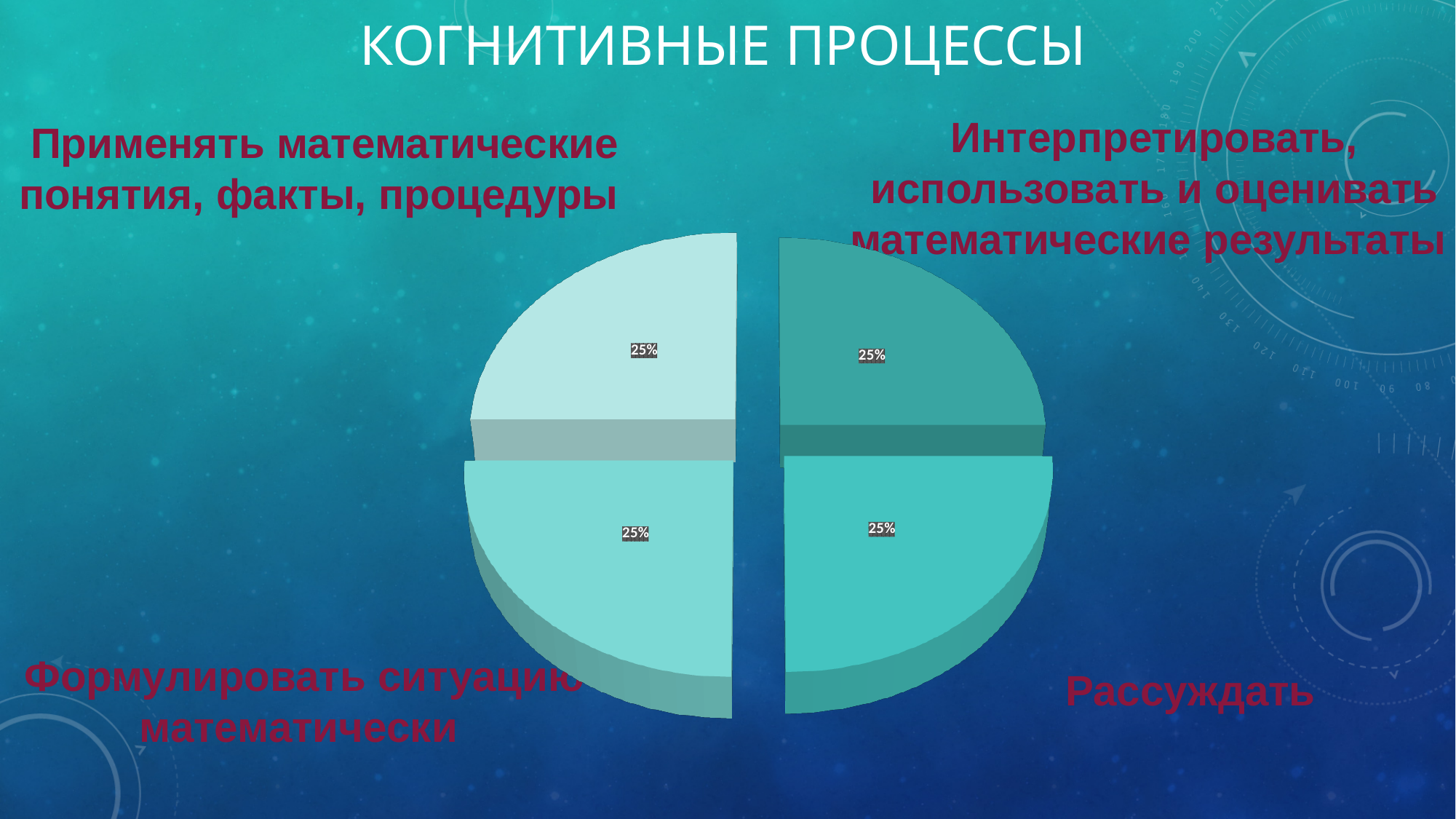
How many slices does the pie chart have? 4 What is the total of all four slice values in the pie chart? 100% What is the difference between the value of the slice labelled Рассуждать and the slice labelled Формулировать ситуацию математически? 0% What share of the pie does the top-right slice (Интерпретировать, использовать и оценивать математические результаты) represent? 25% What is the title of the slide containing the pie chart? КОГНИТИВНЫЕ ПРОЦЕССЫ What value is printed on each slice of the pie chart? 25% What share of the pie does the bottom-right slice (Рассуждать) represent? 25% What share of the pie does the bottom-left slice (Формулировать ситуацию математически) represent? 25% Do all four slices of the pie chart have the same value? Yes What kind of chart is shown on the slide? Pie chart